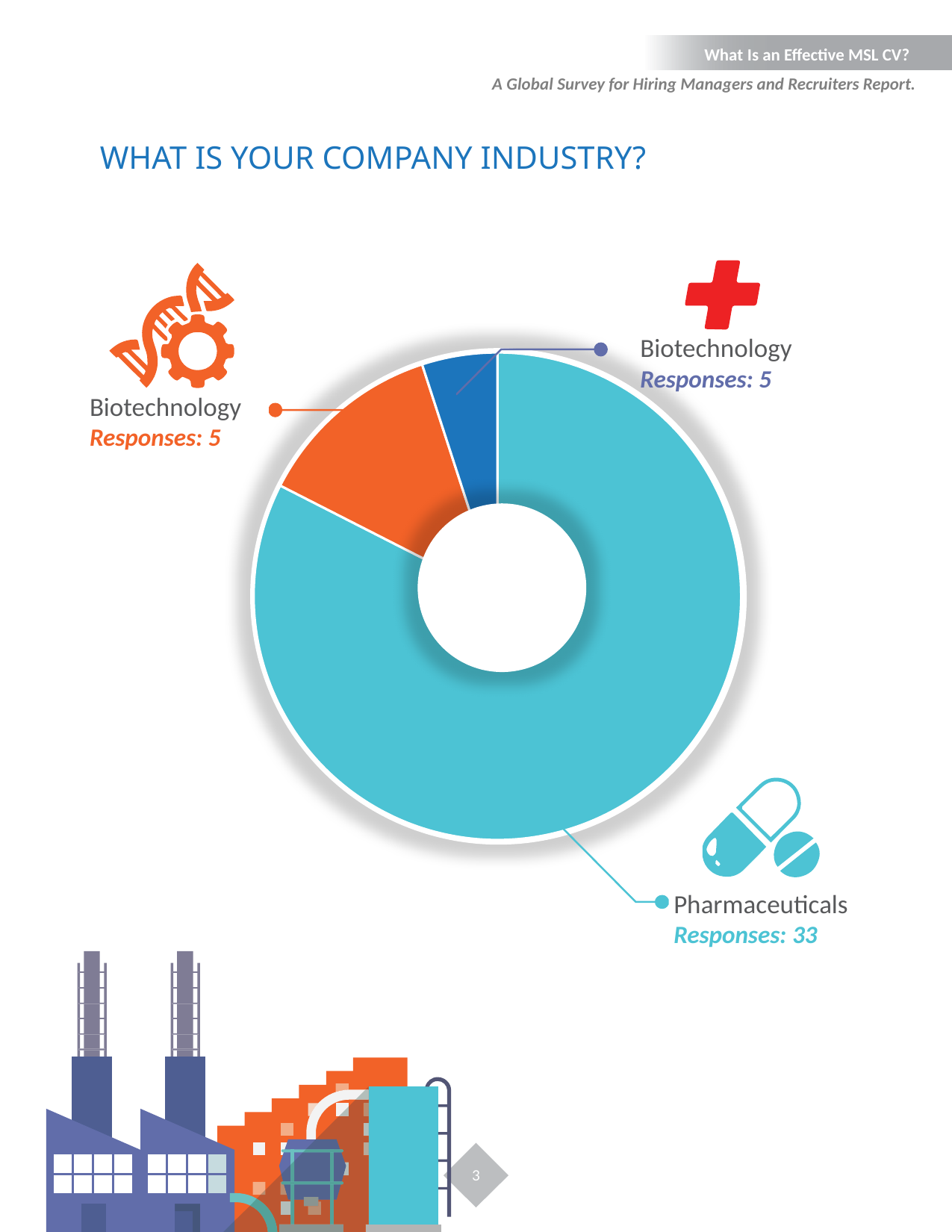
What kind of chart is shown on the slide? Pie (donut) chart How many responses are shown for the Biotechnology label on the upper right (dark blue slice)? 5 How many slices does the chart have? 3 Which category label has the fewest responses? Biotechnology How many more responses does Pharmaceuticals have than the orange Biotechnology slice? 28 What colour is the Pharmaceuticals slice? Teal (light blue) Which category has the most responses? Pharmaceuticals How many responses does the Pharmaceuticals category have? 33 Which has more responses, Pharmaceuticals or the orange Biotechnology slice? Pharmaceuticals How many responses are shown for the Biotechnology label on the left (orange slice)? 5 What is the title of the slide above the chart? WHAT IS YOUR COMPANY INDUSTRY? What is the total number of responses across all slices of the chart? 43